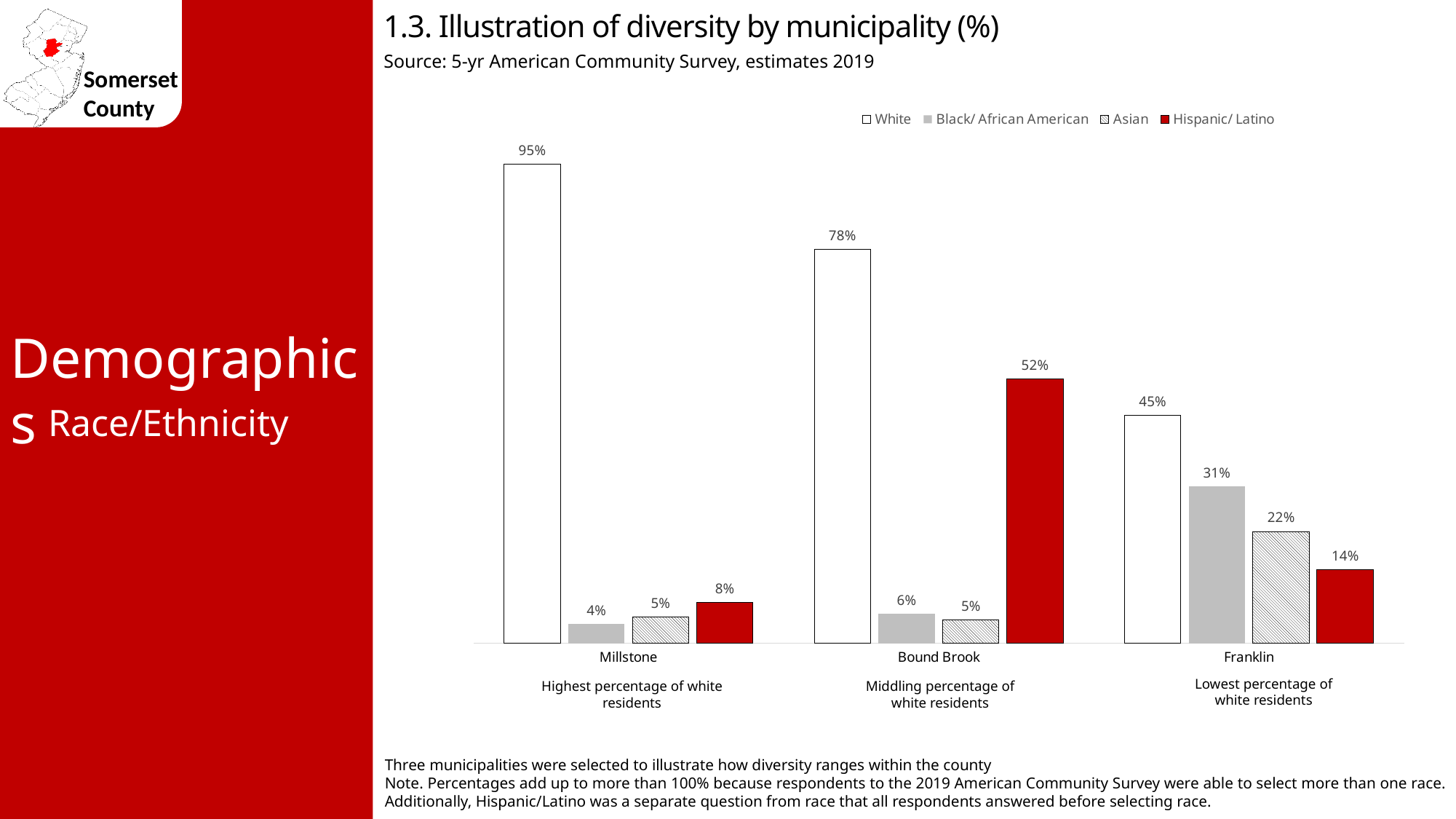
Which is larger: the Black/ African American percentage for Franklin or the Asian percentage for Franklin? Black/ African American What is the difference between the White percentage for Millstone and the White percentage for Franklin? 50% Which municipality has the lowest Hispanic/ Latino percentage? Millstone What is the White percentage for Millstone? 95% Which series is shown in red? Hispanic/ Latino What is the Asian percentage for Franklin? 22% Which municipality has the highest White percentage? Millstone What is the Black/ African American percentage for Millstone? 4% How many municipalities are shown on the x axis? 3 What kind of chart is shown on the slide? Bar chart How many series does the legend list? 4 What is the Hispanic/ Latino percentage for Bound Brook? 52%